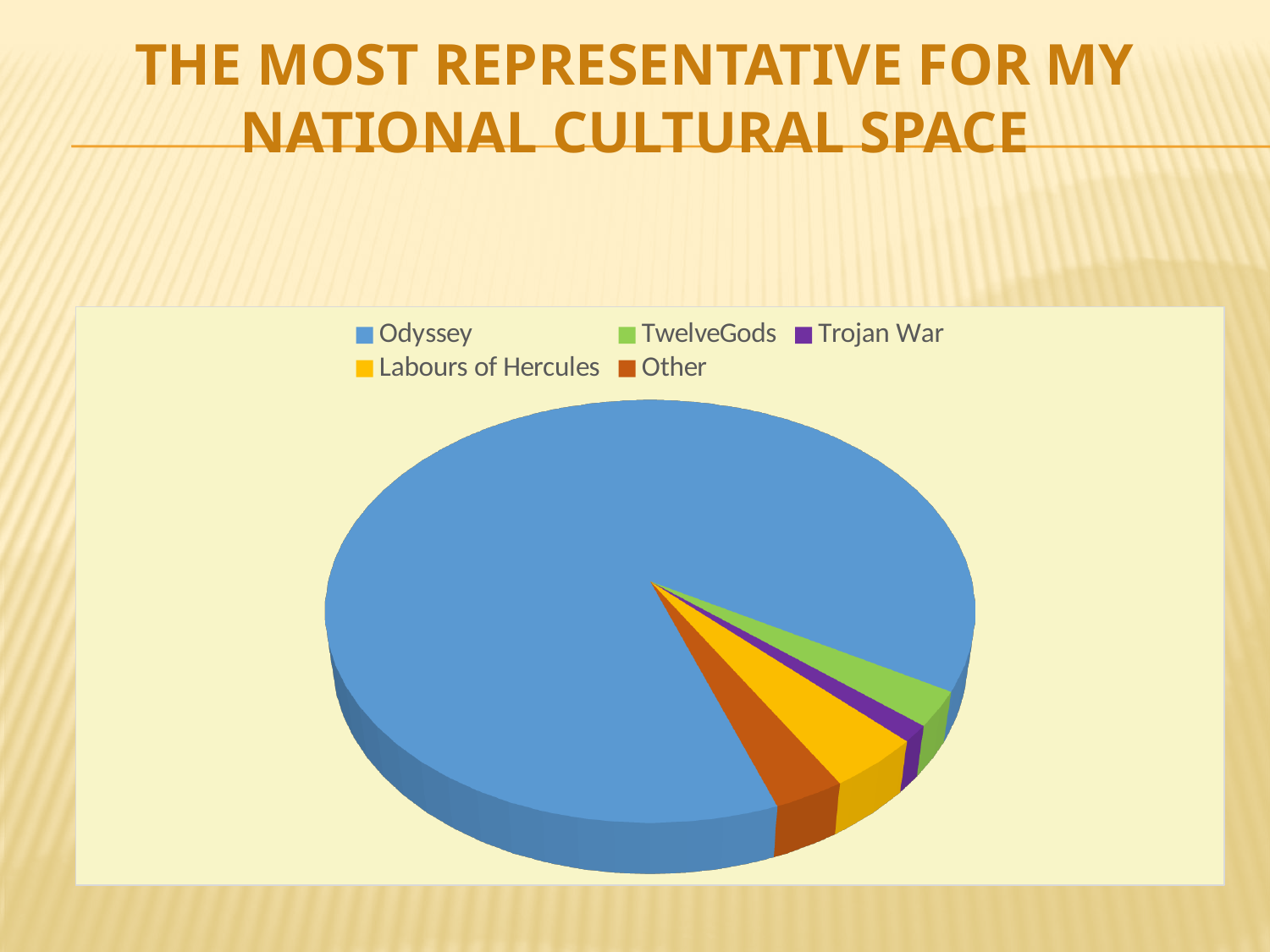
How many categories (slices) does the pie chart have? 5 Which category has the largest slice of the pie chart? Odyssey Which category has the smallest slice of the pie chart? Trojan War Which slice is larger, Odyssey or Other? Odyssey How many entries does the legend of the pie chart list? 5 Which slice is larger, TwelveGods or Trojan War? TwelveGods What is the title of the slide containing the pie chart? The Most Representative for My National Cultural Space Is Odyssey's share of the pie greater or less than 50%? greater Which colour represents Odyssey in the pie chart? blue What kind of chart is shown on the slide? pie chart Which slice is larger, Labours of Hercules or Trojan War? Labours of Hercules